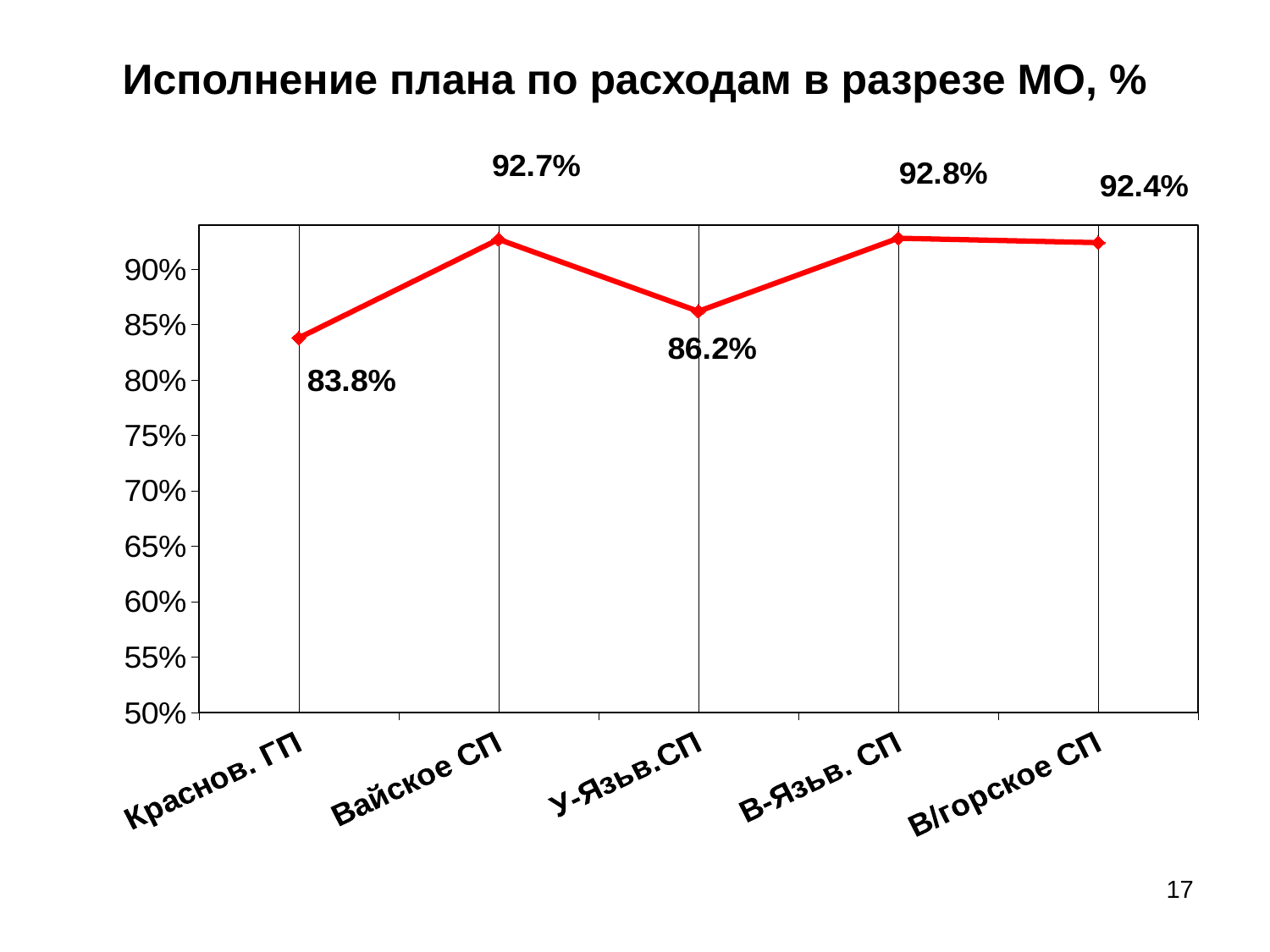
What type of chart is shown on the slide? line chart What is the title of the chart? Исполнение плана по расходам в разрезе МО, % What is the value for У-Язьв.СП? 86.2% What is the difference between the values for Вайское СП and Краснов. ГП? 8.9% What is the value for Краснов. ГП? 83.8% What is the value for Вайское СП? 92.7% What is the value for В/горское СП? 92.4% Which category has the highest value? В-Язьв. СП How many categories are plotted on the x axis? 5 Which is larger, the value for У-Язьв.СП or the value for В-Язьв. СП? В-Язьв. СП Is the value for У-Язьв.СП greater or less than 90%? less Which category has the lowest value? Краснов. ГП